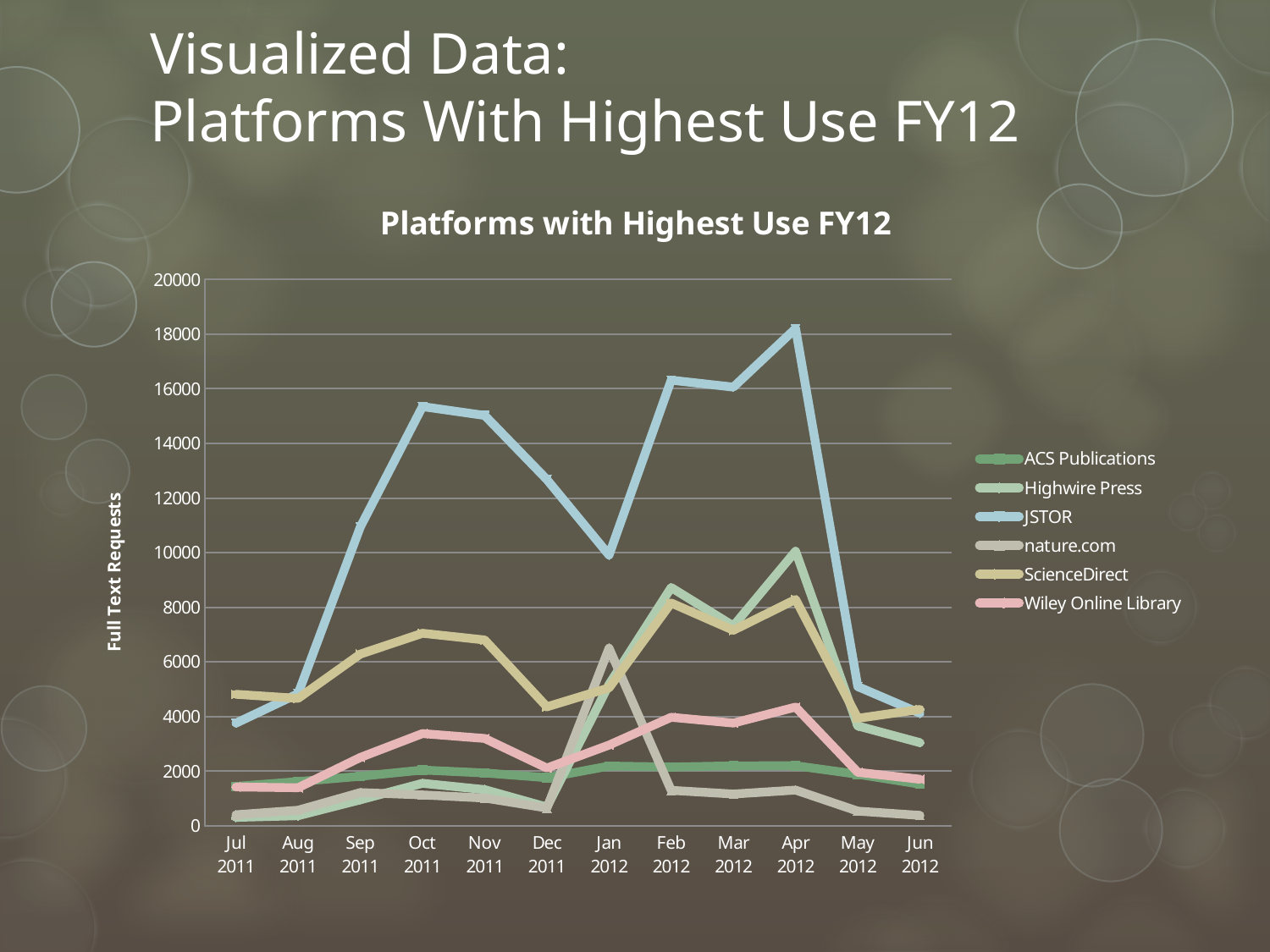
Which platform has the lowest value in Jun 2012? nature.com Is the value for JSTOR in Jan 2012 greater or less than 12000? less How many months are plotted along the x axis? 12 Is the value for JSTOR in Apr 2012 greater or less than 16000? greater What is the title of the chart? Platforms with Highest Use FY12 What kind of chart is shown on the slide? line chart In which month does JSTOR reach its highest value? Apr 2012 What is the label on the vertical axis? Full Text Requests In Jul 2011, which is larger, JSTOR or ScienceDirect? ScienceDirect Does the JSTOR line rise or fall from Apr 2012 to May 2012? fall Which platform has the highest value in Apr 2012? JSTOR How many series does the legend list? 6